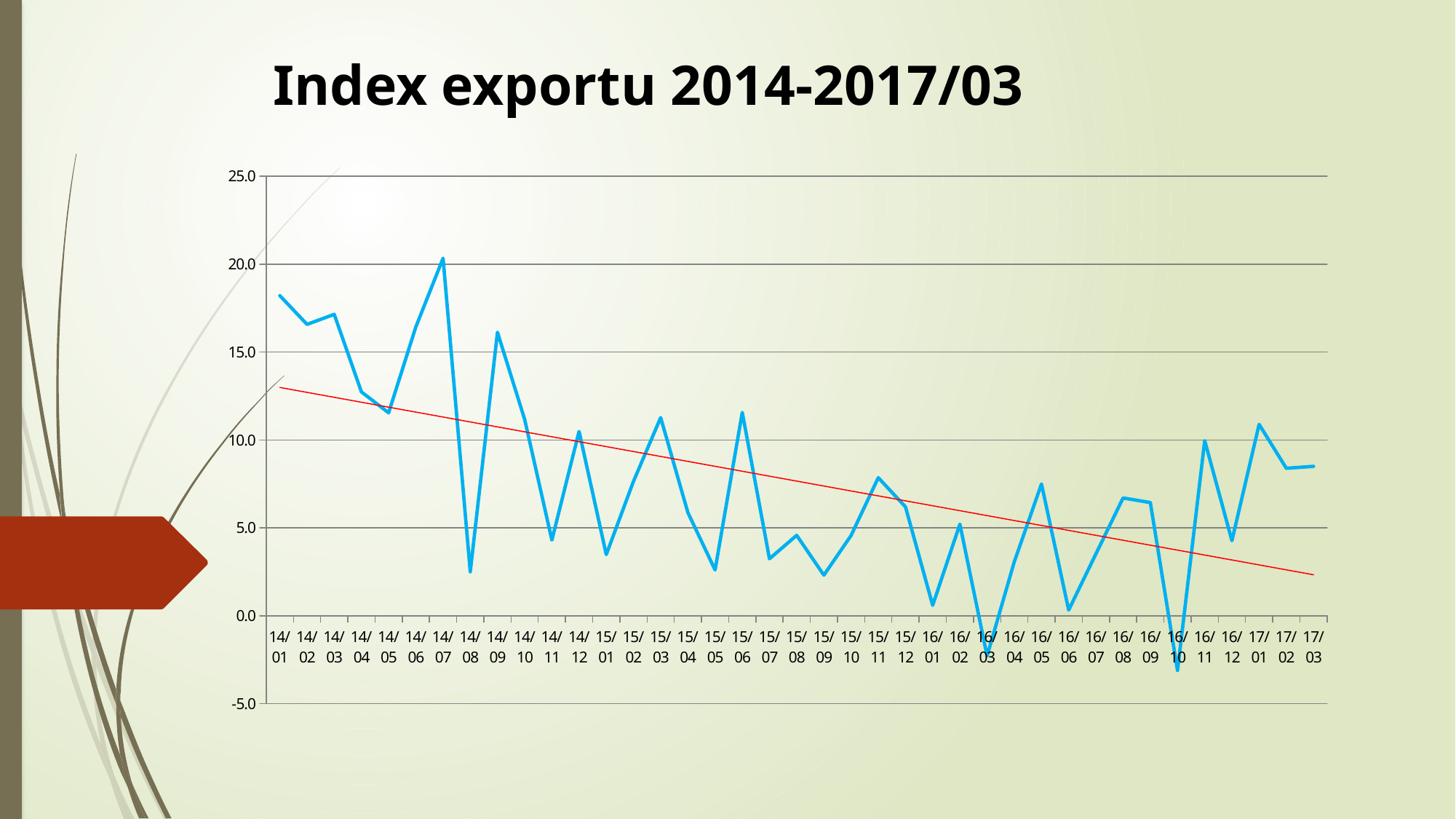
What colour is the straight trend line drawn across the chart? red Is the value for 16/10 greater or less than 0.0? less Is the value for 14/01 greater or less than 15.0? greater Which month has the highest value on the chart? 14/07 Do the values generally rise or fall from 14/01 to 17/03? fall Which month has the lowest value on the chart? 16/10 What kind of chart is shown on the slide? line chart What is the title of the chart? Index exportu 2014-2017/03 How many monthly data points are plotted on the x axis? 39 Which is larger, the value for 14/07 or the value for 14/09? 14/07 Is the value for 14/08 greater or less than 5.0? less